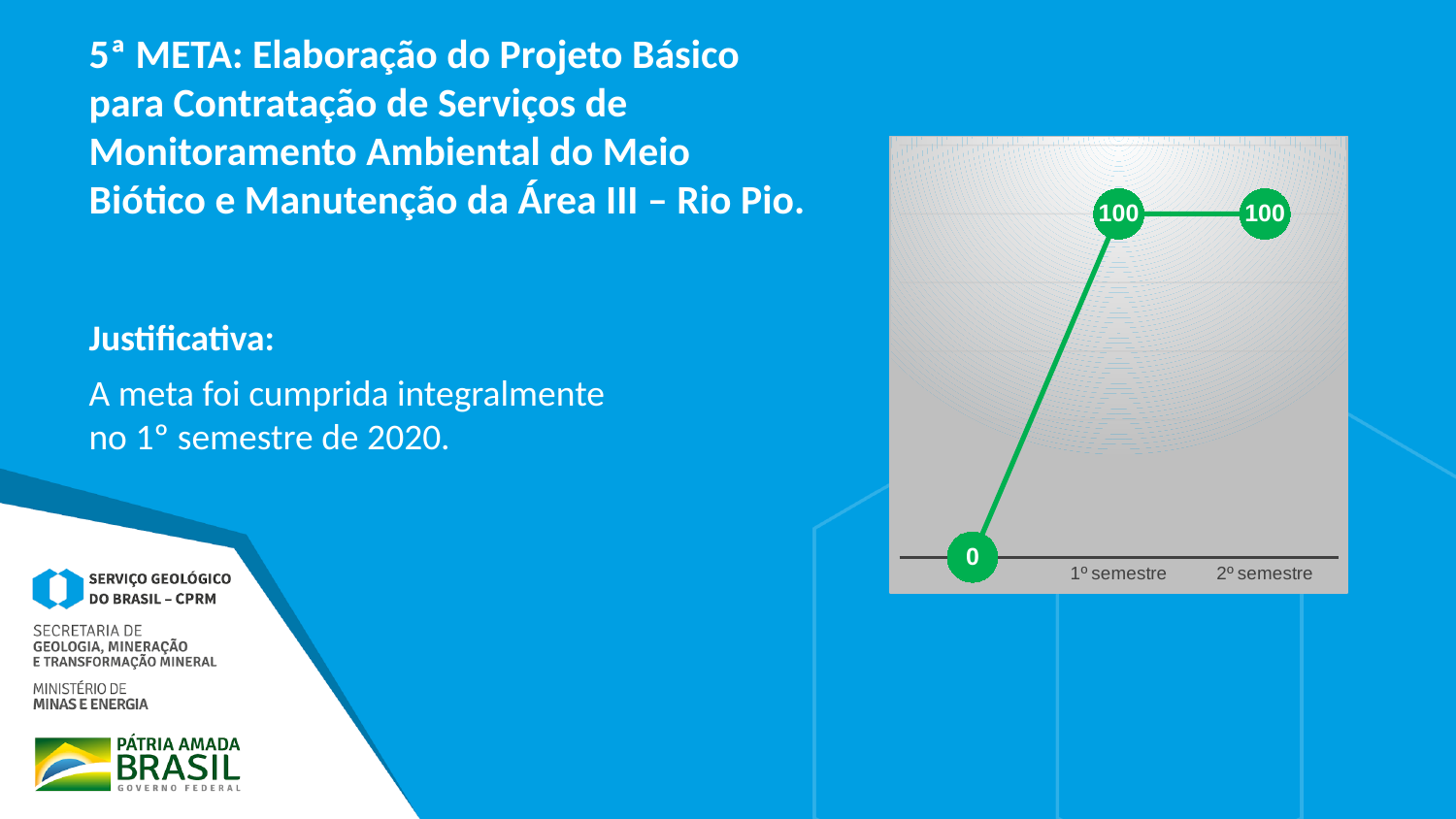
How many data points are plotted on the line? 3 Does the line rise or fall from the first point to 1º semestre? rises What is the difference between the values for 1º semestre and 2º semestre? 0 What colour is the plotted line? green What is the lowest value labelled on the chart? 0 What is the value for 2º semestre? 100 What is the value for 1º semestre? 100 Does the line rise, fall or stay flat between 1º semestre and 2º semestre? stays flat What is the value of the first (leftmost) point on the line? 0 What is the highest value labelled on the chart? 100 Is the value for 1º semestre greater or less than the value of the first point? greater What kind of chart is shown on the slide? line chart